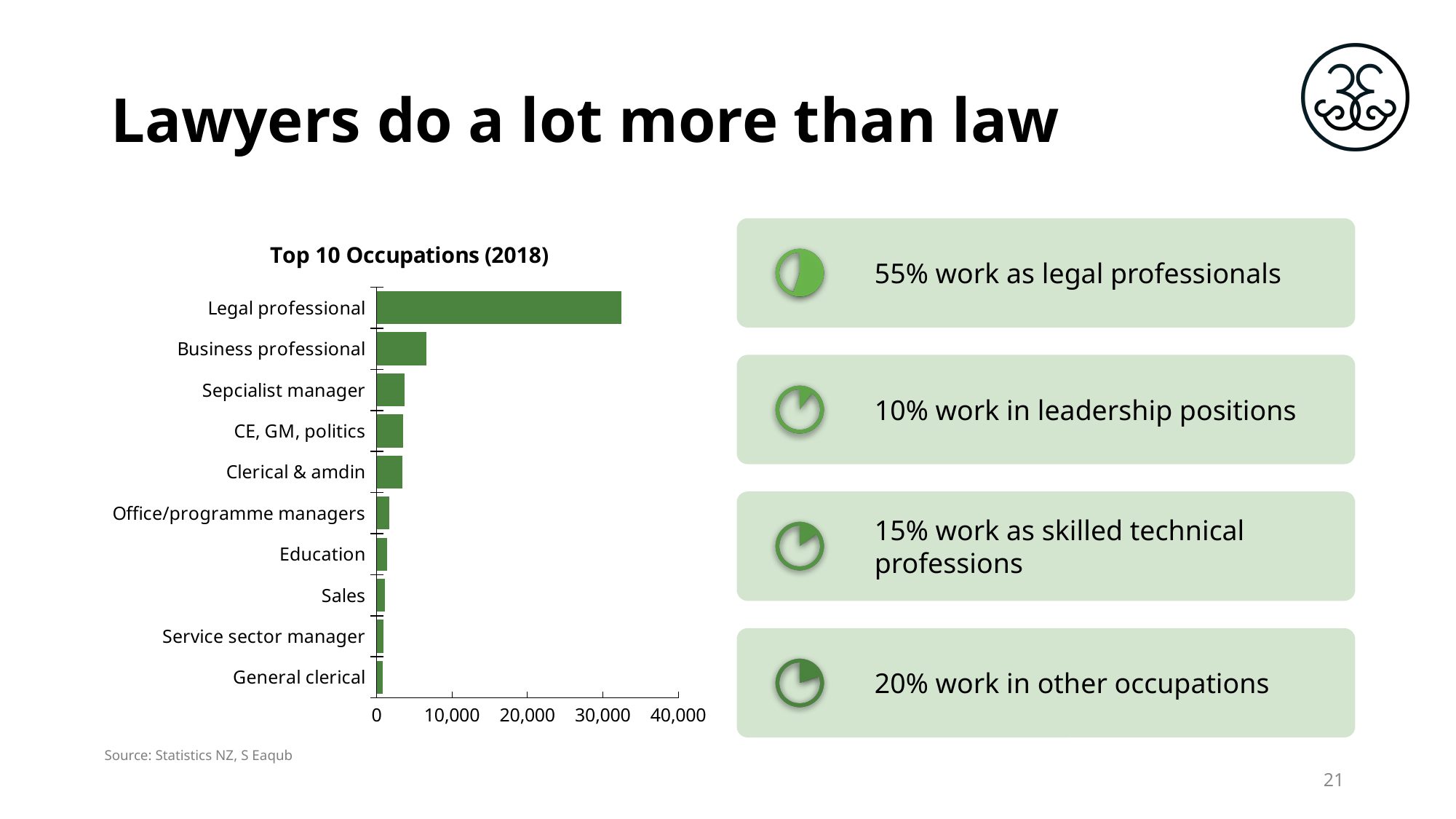
Is the value for Business professional greater or less than 10,000? less Do the bars get longer or shorter going from the top category to the bottom category? shorter How many occupation categories are plotted in the chart? 10 Is the value for Legal professional greater or less than 30,000? greater What is the highest value shown on the horizontal axis of the chart? 40,000 What kind of chart is shown on the slide? Bar chart Which is larger, the value for Business professional or the value for Education? Business professional Is the value for Legal professional greater or less than 40,000? less Which occupation has the highest value in the chart? Legal professional Which is larger, the value for Legal professional or the value for Business professional? Legal professional What is the title of the chart? Top 10 Occupations (2018)